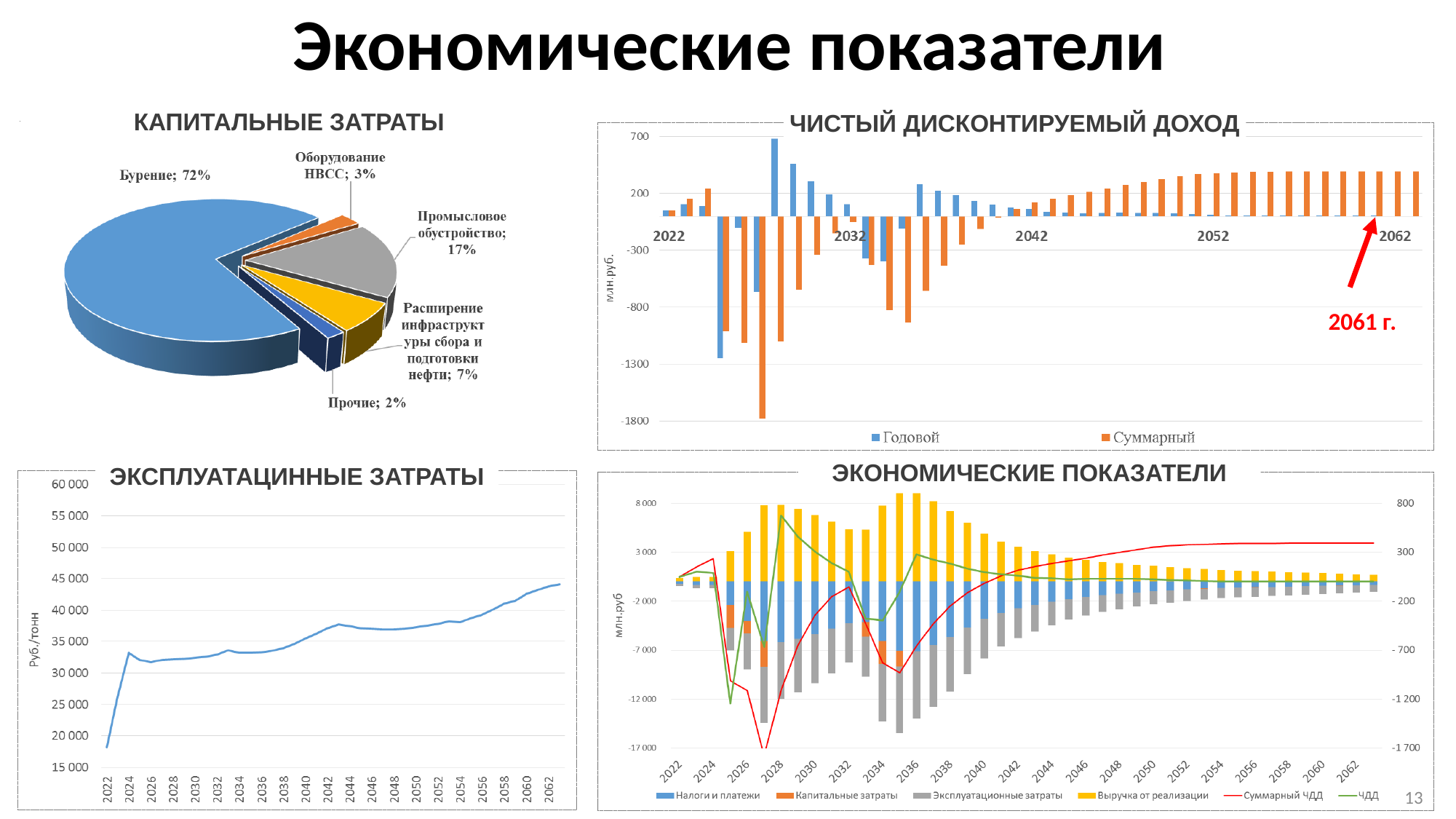
In the КАПИТАЛЬНЫЕ ЗАТРАТЫ pie chart, how many slices are there? 5 In the КАПИТАЛЬНЫЕ ЗАТРАТЫ pie chart, which category has the smallest share? Прочие In the КАПИТАЛЬНЫЕ ЗАТРАТЫ pie chart, what is the difference in share between Промысловое обустройство and Оборудование НВСС? 14% In the ЧИСТЫЙ ДИСКОНТИРУЕМЫЙ ДОХОД chart, how many series does the legend list? 2 In the КАПИТАЛЬНЫЕ ЗАТРАТЫ pie chart, what share does Бурение have? 72% In the ЭКОНОМИЧЕСКИЕ ПОКАЗАТЕЛИ chart at the bottom right, how many series does the legend list? 6 What kind of chart is КАПИТАЛЬНЫЕ ЗАТРАТЫ? Pie chart In the ЭКСПЛУАТАЦИННЫЕ ЗАТРАТЫ chart, do the values generally rise or fall from 2022 to 2062? rise In the ЭКСПЛУАТАЦИННЫЕ ЗАТРАТЫ chart, is the value for 2062 greater or less than 40 000? greater In the КАПИТАЛЬНЫЕ ЗАТРАТЫ pie chart, what share does Промысловое обустройство have? 17% In the ЧИСТЫЙ ДИСКОНТИРУЕМЫЙ ДОХОД chart, is the lowest Суммарный value (around 2028) greater or less than -1300? less In the КАПИТАЛЬНЫЕ ЗАТРАТЫ pie chart, which is larger: Расширение инфраструктуры сбора и подготовки нефти or Оборудование НВСС? Расширение инфраструктуры сбора и подготовки нефти